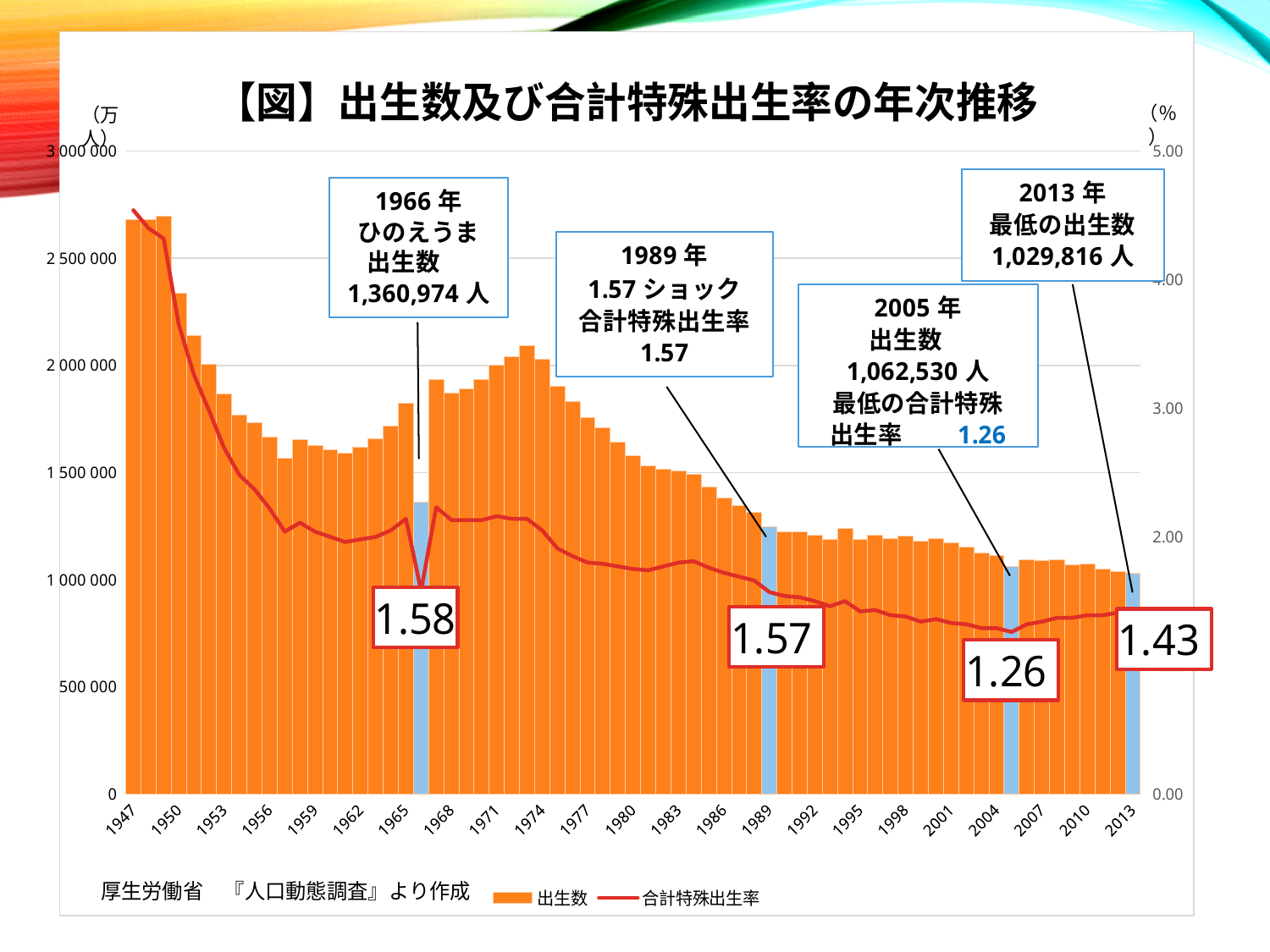
What was the number of births in 2005? 1,062,530 人 What was the total fertility rate in 1989? 1.57 What was the number of births in 2013? 1,029,816 人 What was the total fertility rate (合計特殊出生率) in 1966? 1.58 What was the total fertility rate in 2013? 1.43 What was the total fertility rate in 2005? 1.26 What is the title of the chart? 【図】出生数及び合計特殊出生率の年次推移 What are the two series named in the legend? 出生数 and 合計特殊出生率 How many series does the chart legend list? 2 What was the number of births (出生数) in 1966 according to the annotation? 1,360,974 人 What is the difference between the number of births in 2005 and in 2013? 32,714 人 Which year is labelled as having the lowest number of births (最低の出生数)? 2013